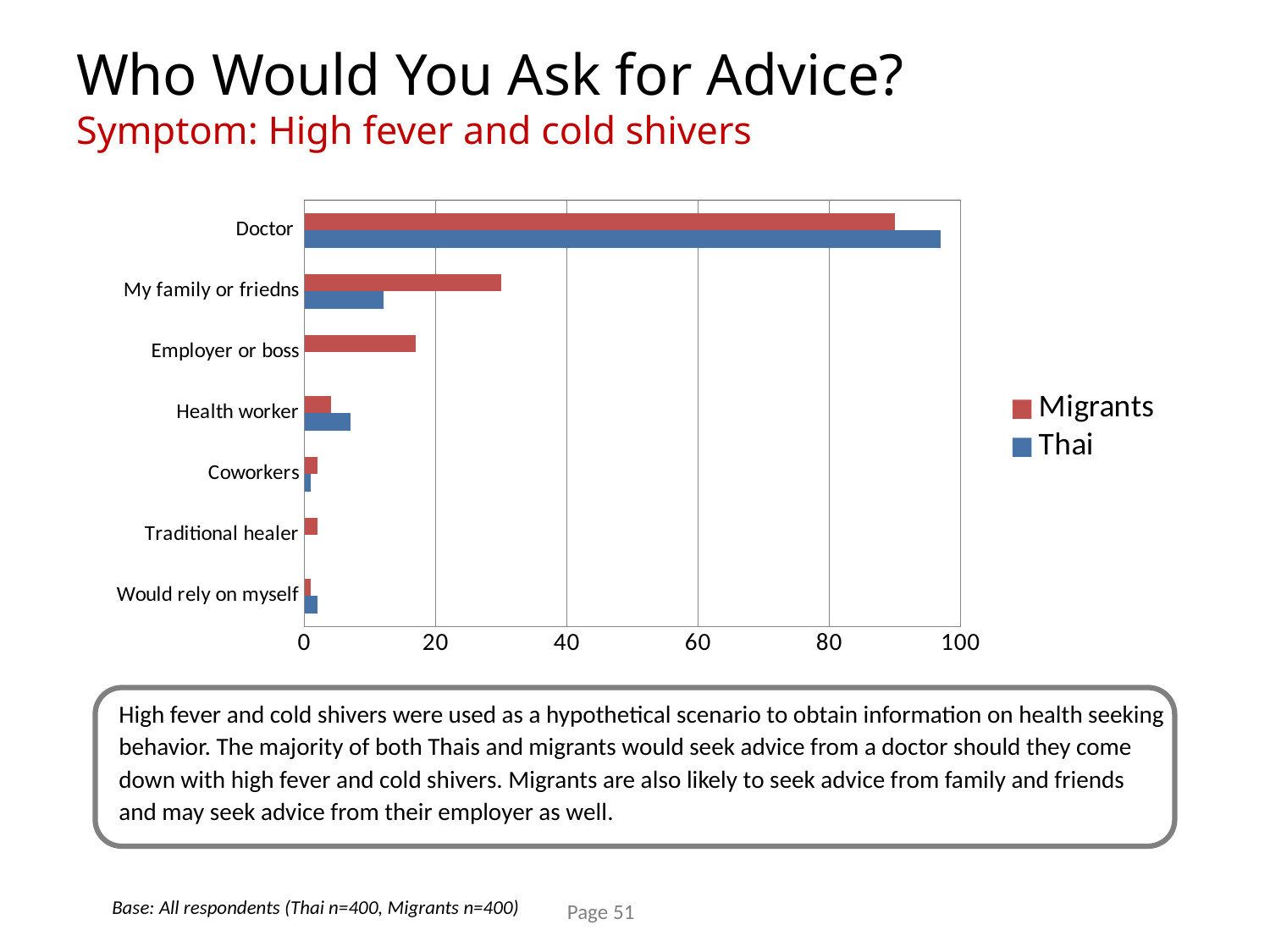
Which colour represents the Migrants series in the legend? red Which category has the highest value for Thai? Doctor Is the Migrants value for Doctor greater or less than 80? greater How many categories are shown on the chart? 7 For My family or friedns, which series has the larger value, Migrants or Thai? Migrants Is the Migrants value for My family or friedns greater or less than 20? greater How many series does the legend list? 2 Is the Thai value for My family or friedns greater or less than 20? less Which category has the highest value for Migrants? Doctor For Health worker, which series has the larger value, Migrants or Thai? Thai For Doctor, which series has the larger value, Migrants or Thai? Thai What kind of chart is shown on the slide? bar chart